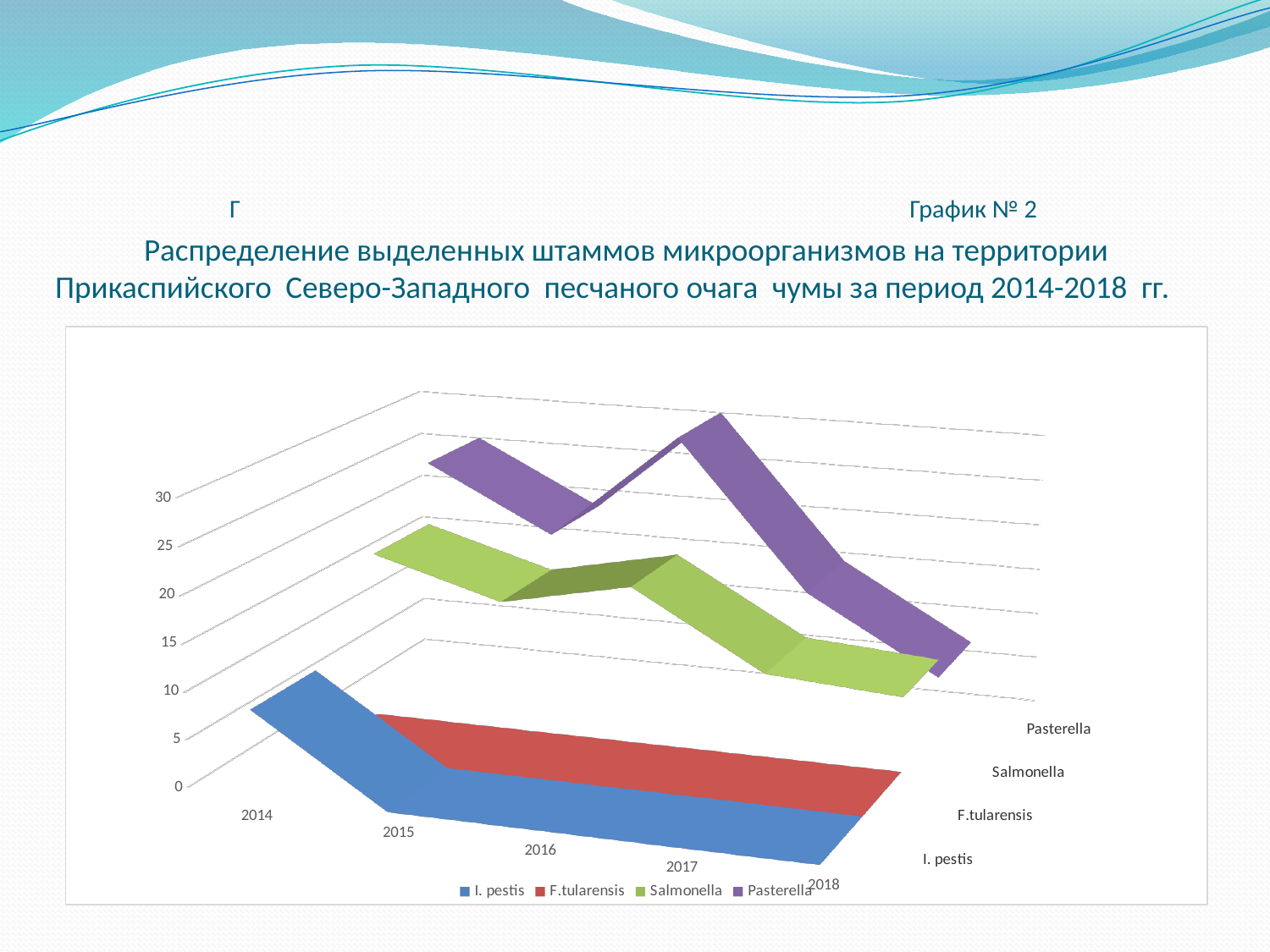
Does the Salmonella series rise or fall from 2016 to 2018? fall How many series does the chart legend list? 4 Does the Pasterella series rise or fall from 2016 to 2018? fall Which series are listed in the chart legend? I. pestis, F.tularensis, Salmonella, Pasterella What is the highest value shown on the vertical axis of the chart? 30 Does the I. pestis series rise or fall from 2014 to 2015? fall Which series is shown in purple on the chart? Pasterella In which year does the Pasterella series reach its highest value? 2016 What kind of chart is shown on the slide? 3D line chart How many years are shown along the x axis of the chart? 5